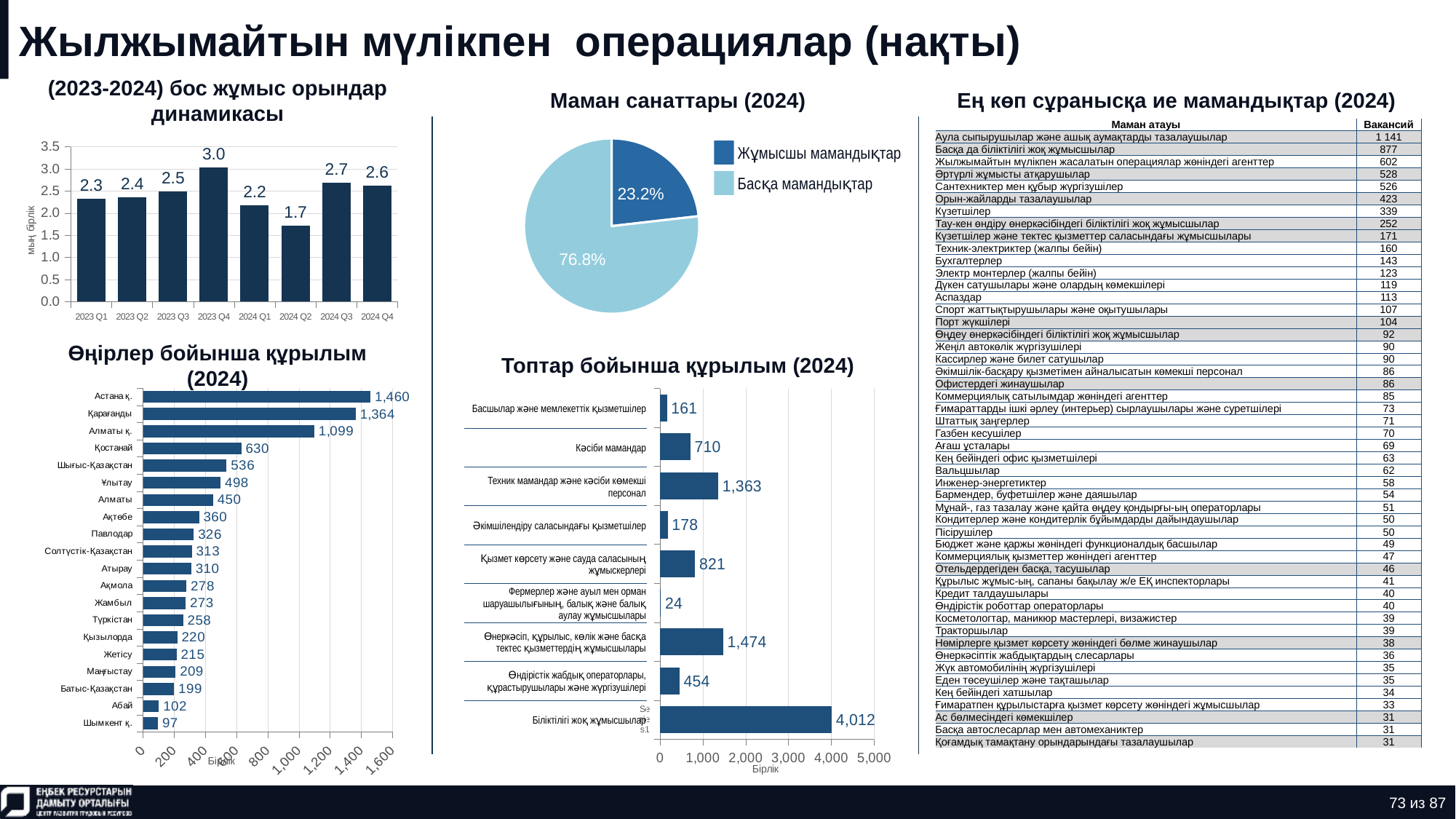
In the pie chart 'Маман санаттары (2024)', what share is 'Жұмысшы мамандықтар'? 23.2% In the chart 'Өңірлер бойынша құрылым (2024)', which region has the highest value? Астана қ. In the chart 'Топтар бойынша құрылым (2024)', which group has the lowest value? Фермерлер және ауыл мен орман шаруашылығының, балық және балық аулау жұмысшылары In the chart '(2023-2024) бос жұмыс орындар динамикасы', which quarter has the lowest value? 2024 Q2 In the chart 'Топтар бойынша құрылым (2024)', which is larger: 'Техник мамандар және кәсіби көмекші персонал' or 'Қызмет көрсету және сауда саласының жұмыскерлері'? Техник мамандар және кәсіби көмекші персонал In the chart '(2023-2024) бос жұмыс орындар динамикасы', how many quarters are plotted? 8 In the chart 'Топтар бойынша құрылым (2024)', what is the value for 'Кәсіби мамандар'? 710 In the chart '(2023-2024) бос жұмыс орындар динамикасы', what is the value for 2023 Q4? 3.0 In the chart '(2023-2024) бос жұмыс орындар динамикасы', what is the difference between 2024 Q3 and 2024 Q2? 1.0 What type of chart is 'Маман санаттары (2024)'? pie chart In the chart 'Өңірлер бойынша құрылым (2024)', how many regions are listed? 20 In the chart 'Өңірлер бойынша құрылым (2024)', what is the value for Қостанай? 630